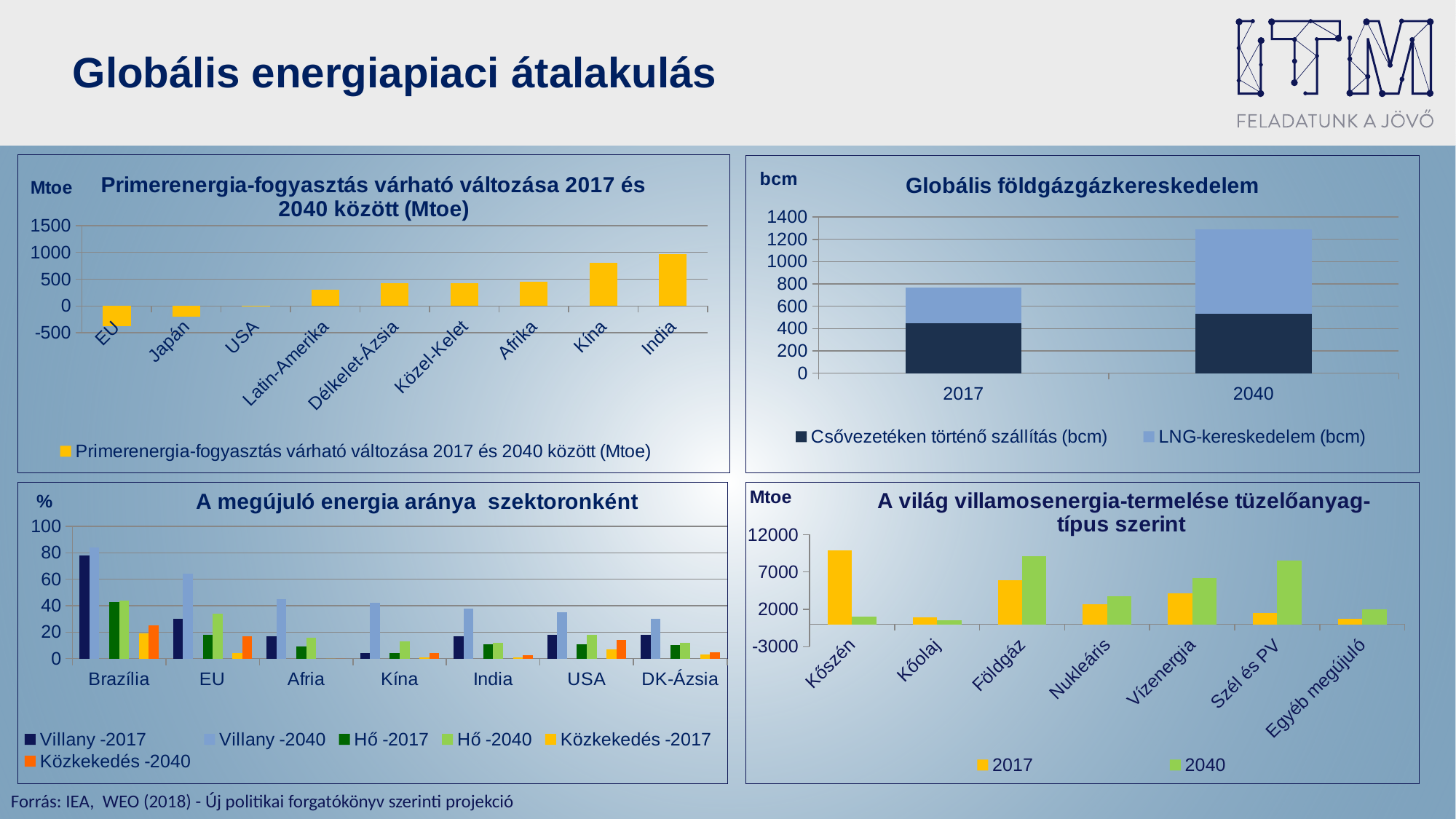
In the chart 'A világ villamosenergia-termelése tüzelőanyag-típus szerint', which category has the highest 2017 value? Kőszén In the chart 'Primerenergia-fogyasztás várható változása 2017 és 2040 között (Mtoe)', do the values generally rise or fall from left to right along the x axis? rise In the chart 'Globális földgázgázkereskedelem', how many series does the legend list? 2 In the chart 'Primerenergia-fogyasztás várható változása 2017 és 2040 között (Mtoe)', which category has the highest value? India In the chart 'A megújuló energia aránya szektoronként', which category has the highest Villany -2040 value? Brazília In the chart 'Globális földgázgázkereskedelem', which year has the larger LNG-kereskedelem (bcm) value, 2017 or 2040? 2040 In the chart 'Primerenergia-fogyasztás várható változása 2017 és 2040 között (Mtoe)', how many categories are shown on the x axis? 9 In the chart 'Primerenergia-fogyasztás várható változása 2017 és 2040 között (Mtoe)', is the value for Kína greater or less than 500? greater What kind of chart is 'A világ villamosenergia-termelése tüzelőanyag-típus szerint'? bar chart In the chart 'A megújuló energia aránya szektoronként', how many series does the legend list? 6 In the chart 'Primerenergia-fogyasztás várható változása 2017 és 2040 között (Mtoe)', which category has the lowest value? EU In the chart 'Globális földgázgázkereskedelem', is the total stacked bar for 2040 greater or less than 1200? greater